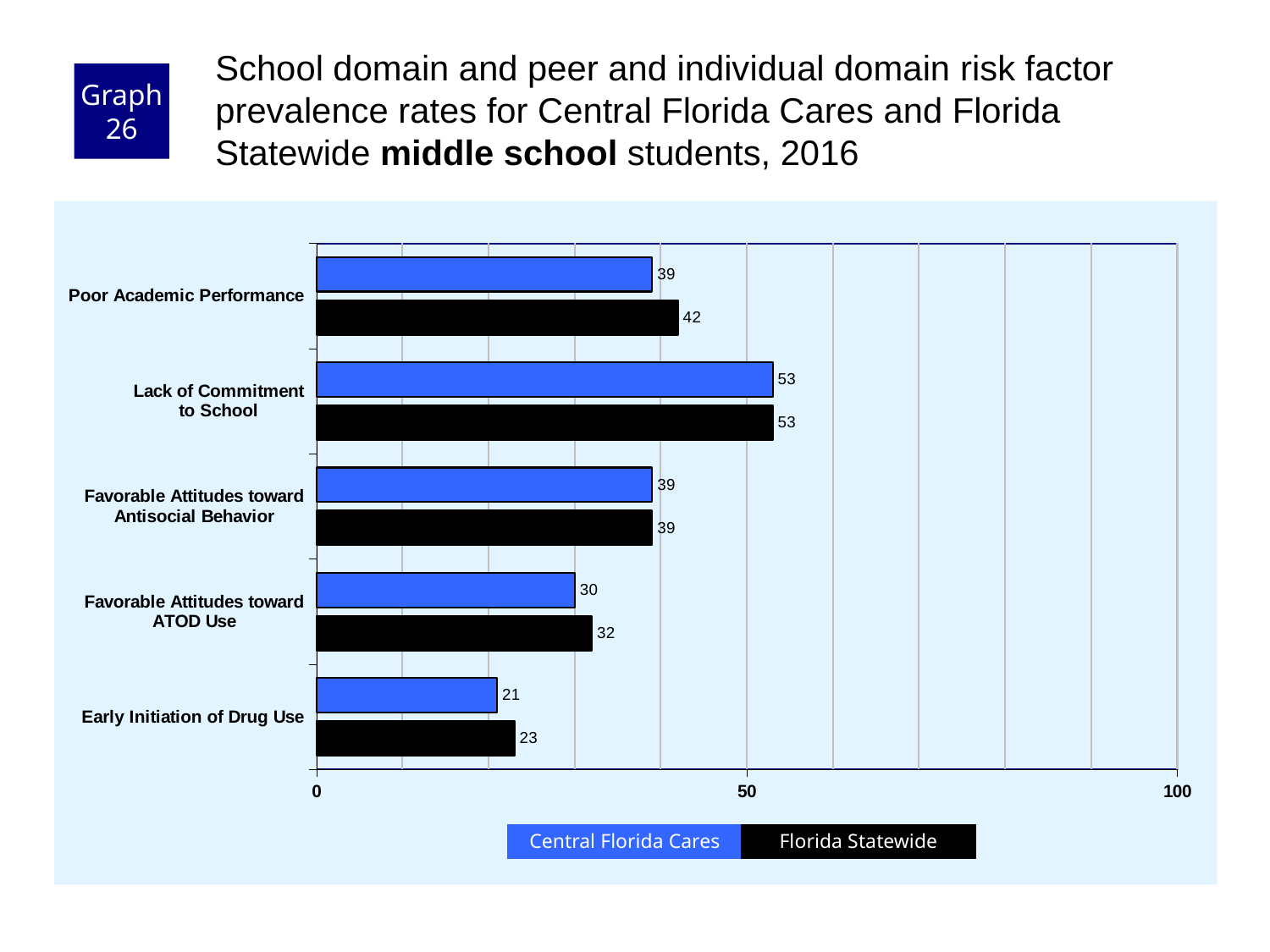
What kind of chart is shown on the slide? Bar chart Which colour represents Florida Statewide in the chart? Black For Favorable Attitudes toward ATOD Use, which is larger: the Central Florida Cares value or the Florida Statewide value? Florida Statewide How many series does the legend list? 2 What is the Central Florida Cares value for Early Initiation of Drug Use? 21 What is the Florida Statewide value for Favorable Attitudes toward ATOD Use? 32 What is the difference between the Florida Statewide and Central Florida Cares values for Poor Academic Performance? 3 Is the Florida Statewide value for Lack of Commitment to School greater or less than 50? greater What is the Central Florida Cares value for Poor Academic Performance? 39 Which risk factor has the highest Central Florida Cares value? Lack of Commitment to School Which risk factor has the lowest Florida Statewide value? Early Initiation of Drug Use How many risk factor categories are shown on the chart? 5